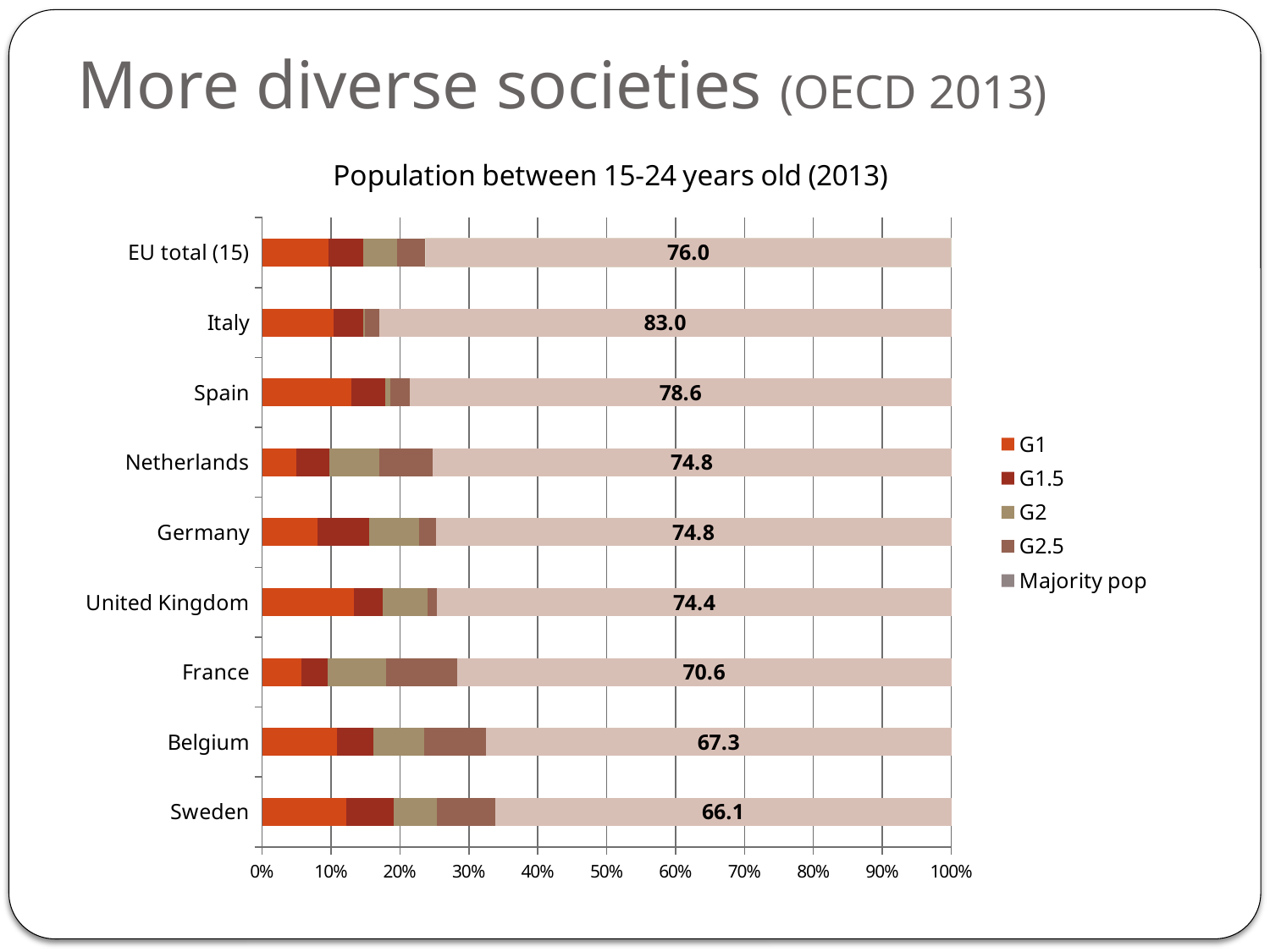
How many series does the legend list? 5 What kind of chart is shown on the slide? Stacked bar chart What is the difference between the Majority pop values for Italy and Sweden? 16.9 Is the G1 value for Netherlands greater or less than 10%? less What is the difference between the Majority pop values for EU total (15) and France? 5.4 How many countries or regions are shown on the chart? 9 What is the Majority pop value for Sweden? 66.1 What is the Majority pop value for France? 70.6 Which country has the lowest Majority pop value? Sweden What is the Majority pop value for Italy? 83.0 Which has a larger Majority pop value, Spain or Belgium? Spain Which country has the highest Majority pop value? Italy